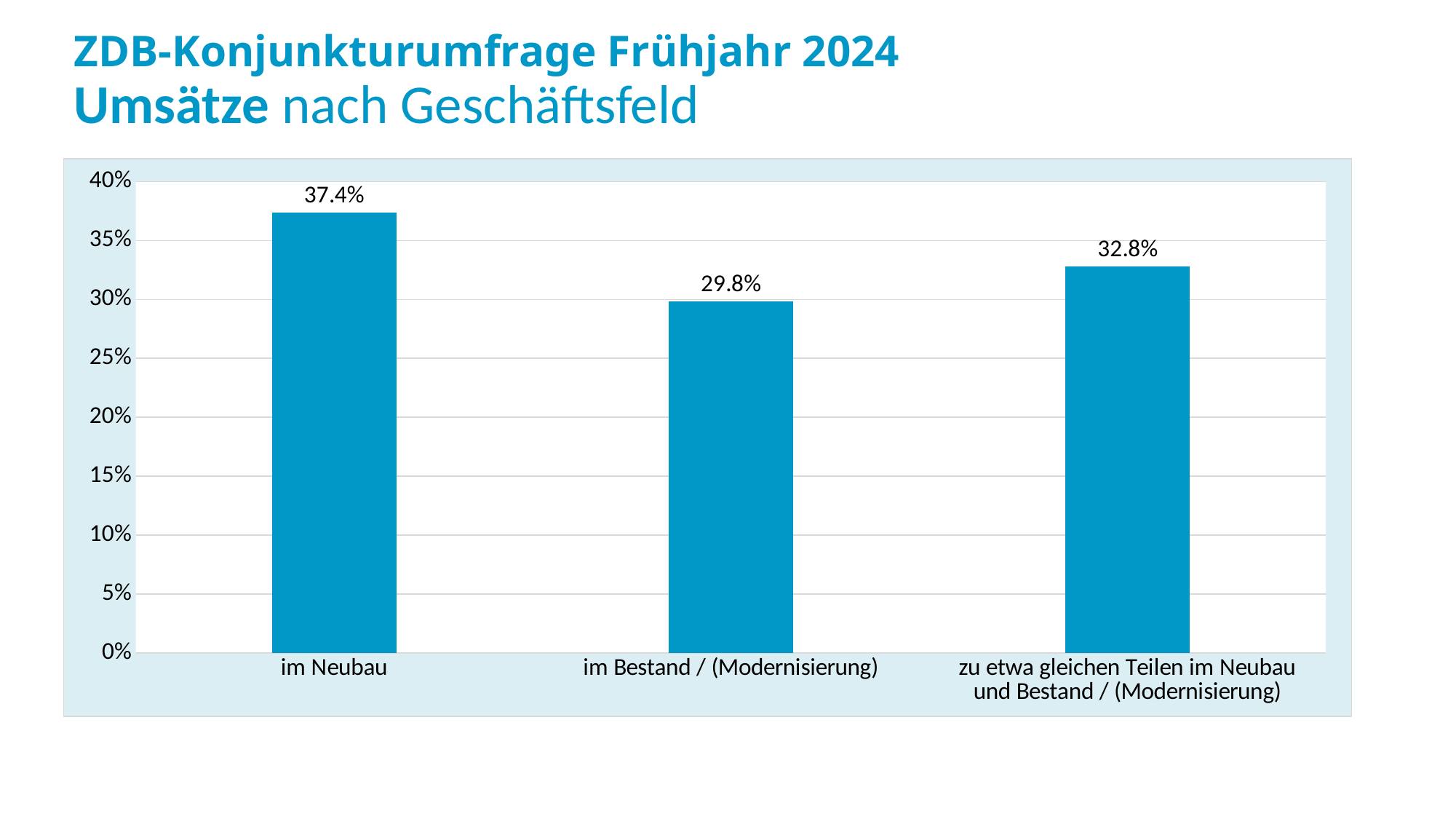
What is the value for "im Bestand / (Modernisierung)"? 29.8% How many categories are shown in the chart? 3 What is the value for "im Neubau"? 37.4% Which category has the highest value? im Neubau What is the value for "zu etwa gleichen Teilen im Neubau und Bestand / (Modernisierung)"? 32.8% What is the difference between the values for "zu etwa gleichen Teilen im Neubau und Bestand / (Modernisierung)" and "im Bestand / (Modernisierung)"? 3.0% Which category has the lowest value? im Bestand / (Modernisierung) What kind of chart is shown on the slide? bar chart Is the value for "im Neubau" greater or less than 35%? greater Which is larger, the value for "im Bestand / (Modernisierung)" or the value for "zu etwa gleichen Teilen im Neubau und Bestand / (Modernisierung)"? zu etwa gleichen Teilen im Neubau und Bestand / (Modernisierung) What is the title of the slide? ZDB-Konjunkturumfrage Frühjahr 2024 Umsätze nach Geschäftsfeld What is the difference between the values for "im Neubau" and "im Bestand / (Modernisierung)"? 7.6%